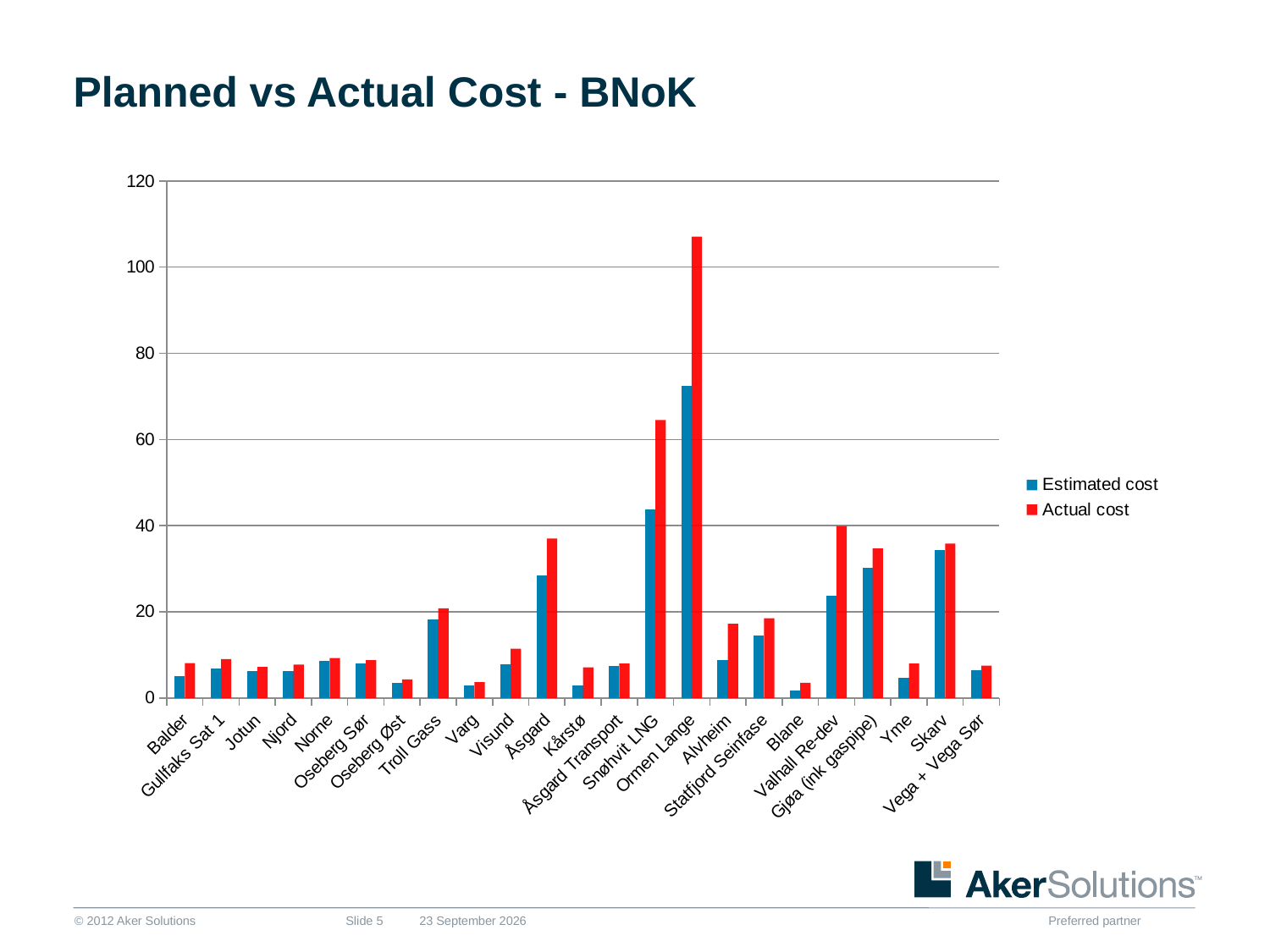
Which category has the highest Actual cost? Ormen Lange Which category has the highest Estimated cost? Ormen Lange Is the Actual cost for Skarv greater or less than 40? less What type of chart is shown on the slide? bar chart Is the Actual cost for Snøhvit LNG greater or less than 60? greater What is the title of the chart? Planned vs Actual Cost - BNoK How many categories are shown on the x axis? 23 Is the Estimated cost for Gjøa (ink gaspipe) greater or less than 20? greater Which category has the lowest Estimated cost? Blane How many series does the legend list? 2 For Valhall Re-dev, which is larger: the Estimated cost or the Actual cost? Actual cost